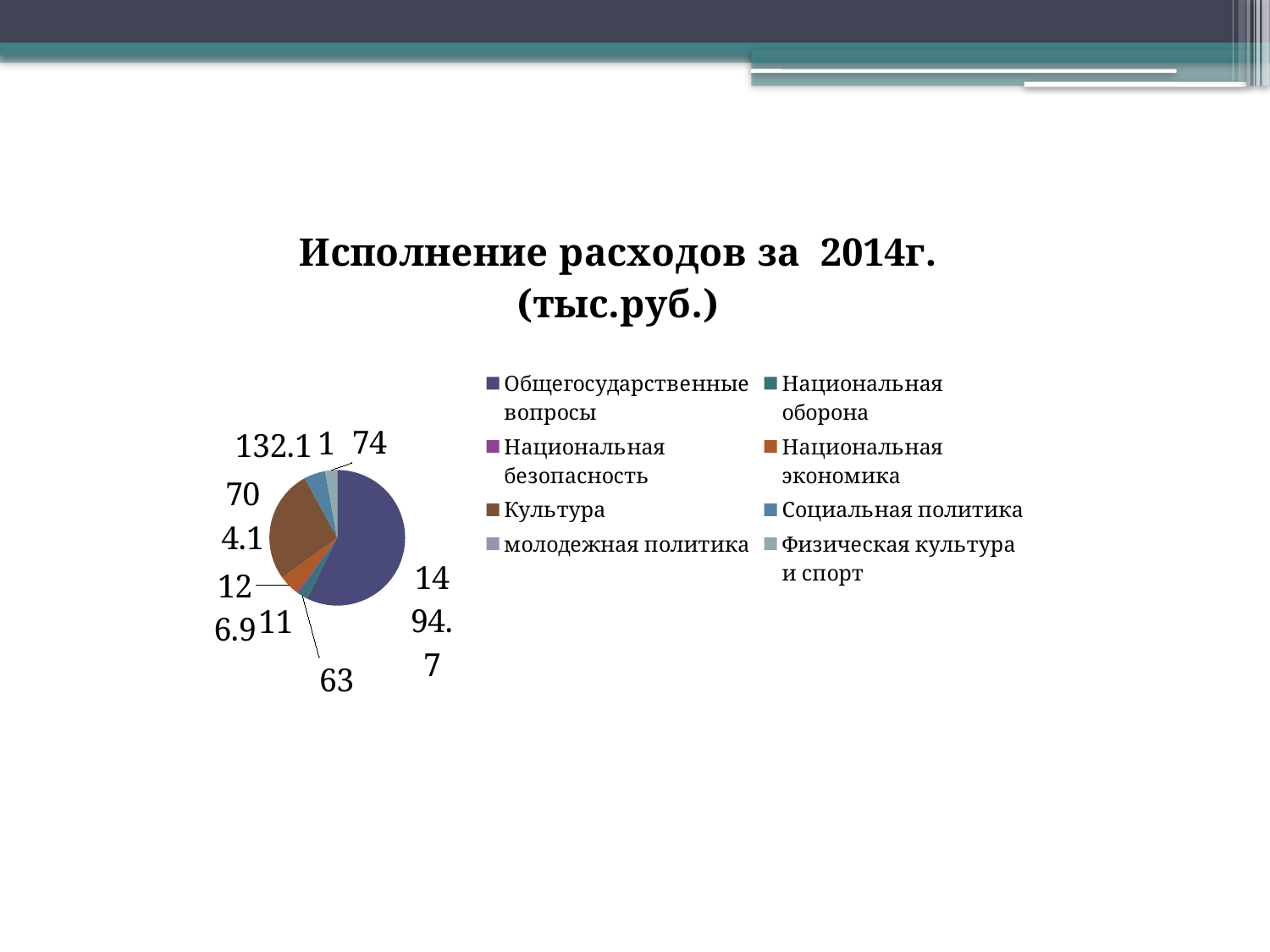
What is the difference between the values for Физическая культура и спорт and Национальная оборона? 11 What is the value for Физическая культура и спорт? 74 What is the value for Социальная политика? 132.1 What is the value for Национальная безопасность? 11 What is the title of the chart? Исполнение расходов за 2014г. (тыс.руб.) What is the value for Национальная оборона? 63 How many categories does the legend of the pie chart list? 8 Which category has the largest slice of the pie? Общегосударственные вопросы Which is larger, the slice for Культура or the slice for Социальная политика? Культура What kind of chart is shown on the slide? pie chart What is the value for молодежная политика? 1 Which category has the smallest slice of the pie? молодежная политика